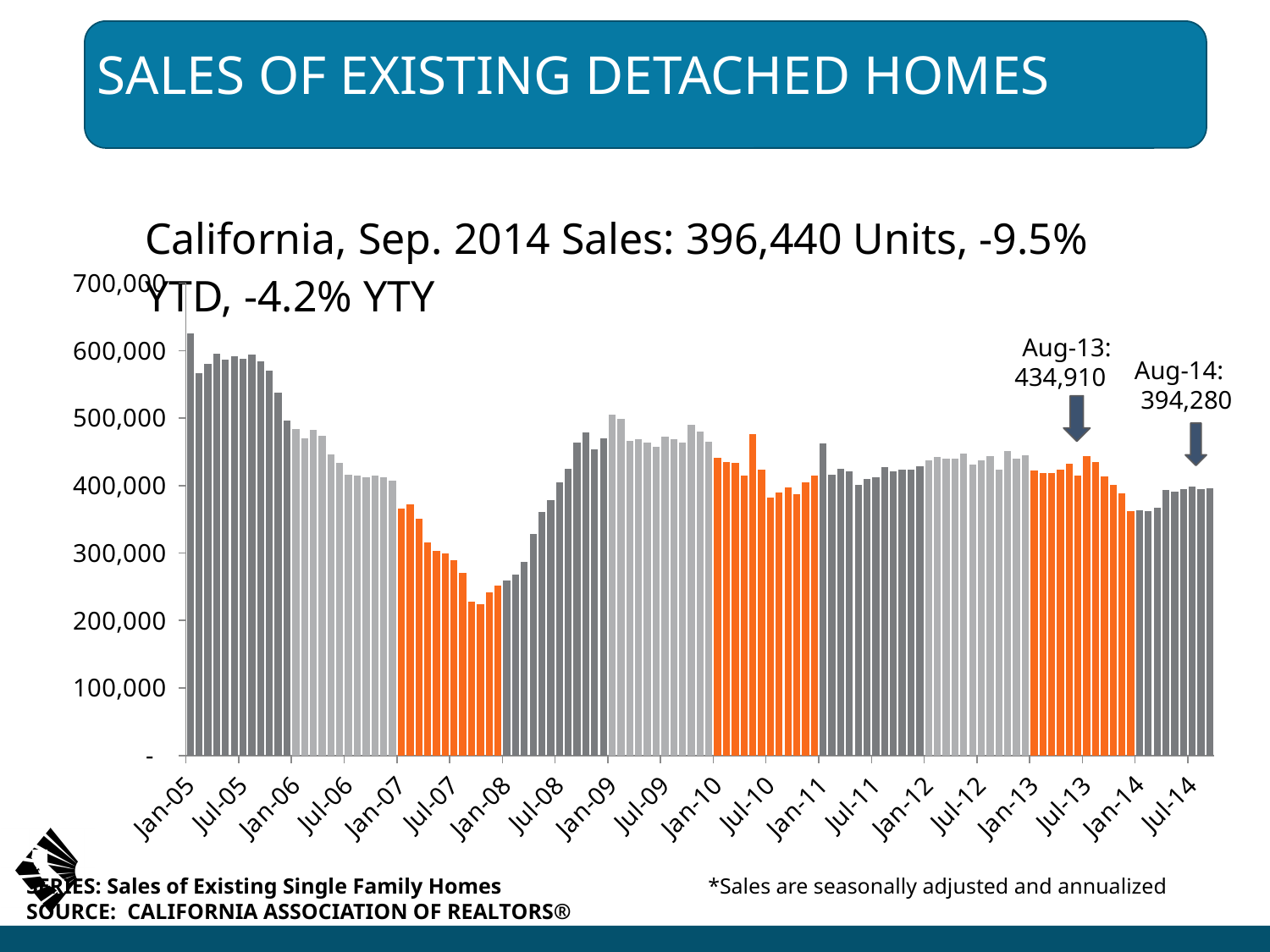
Do the values rise or fall from Jan-05 to Jan-08? Fall What is the difference between the annotated Aug-13 and Aug-14 sales values? 40,630 According to the chart title, how many units were sold in California in Sep. 2014? 396,440 Units Is the value for Jan-05 greater or less than 600,000? greater What is the annotated sales value for Aug-13? 434,910 Which month on the x axis has the highest bar? Jan-05 What is the highest value shown on the y axis? 700,000 Is the value for Jul-07 greater or less than 400,000? less What is the annotated sales value for Aug-14? 394,280 Which is larger, the annotated value for Aug-13 or for Aug-14? Aug-13 What type of chart is shown on the slide? Bar chart Is the value for Jan-08 greater or less than 300,000? less